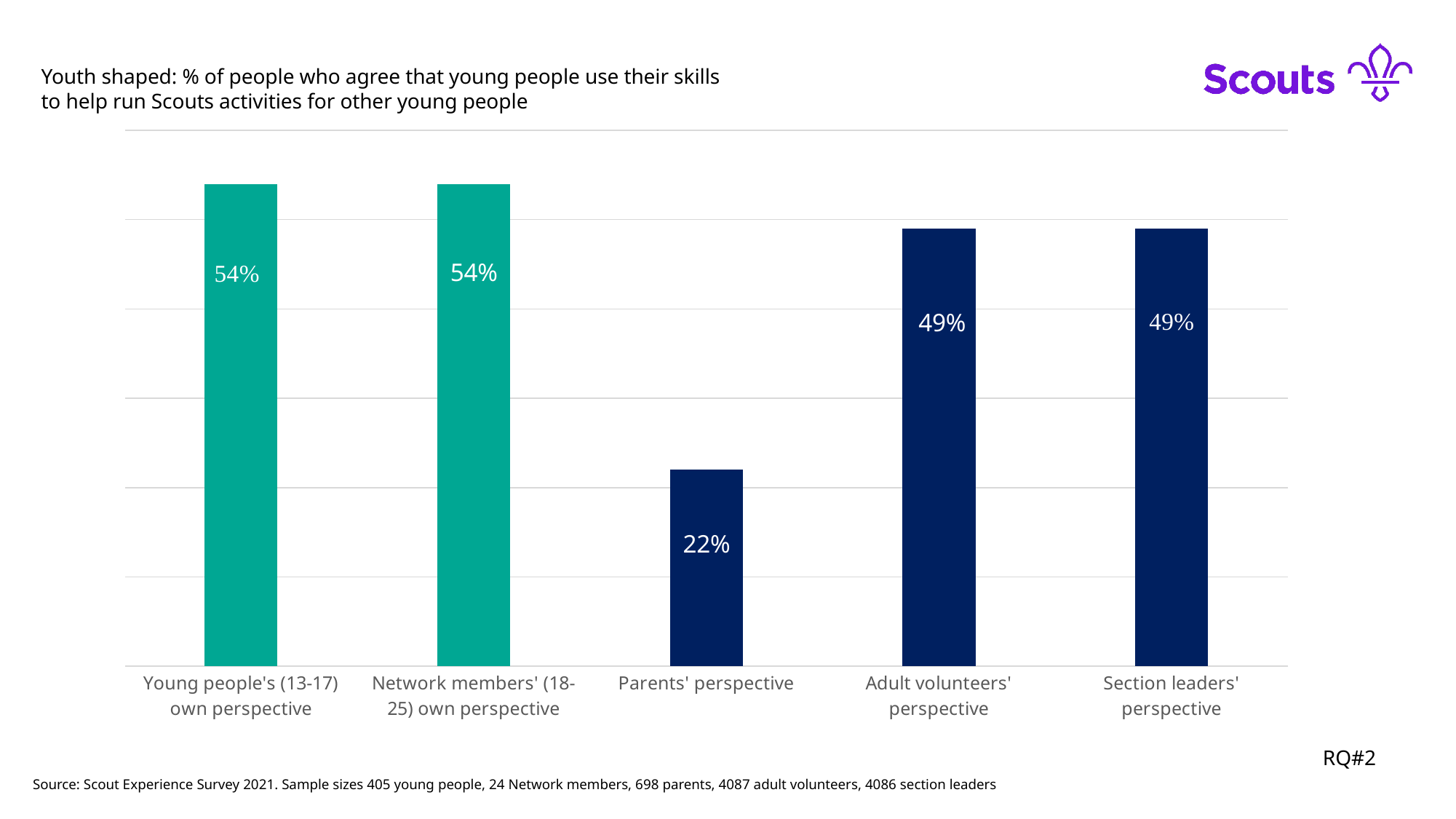
How many categories are shown on the chart? 5 How many bars are coloured teal rather than dark navy? 2 What is the value for Section leaders' perspective? 49% What is the difference between Network members' (18-25) own perspective and Parents' perspective? 32 percentage points What kind of chart is shown on the slide? Bar chart What is the value for Adult volunteers' perspective? 49% What is the value for Young people's (13-17) own perspective? 54% What is the difference between Young people's (13-17) own perspective and Adult volunteers' perspective? 5 percentage points Which category has the lowest value? Parents' perspective Which is larger, the value for Parents' perspective or the value for Section leaders' perspective? Section leaders' perspective According to the source note, what survey is the data from? Scout Experience Survey 2021 What percentage is shown for Parents' perspective? 22%